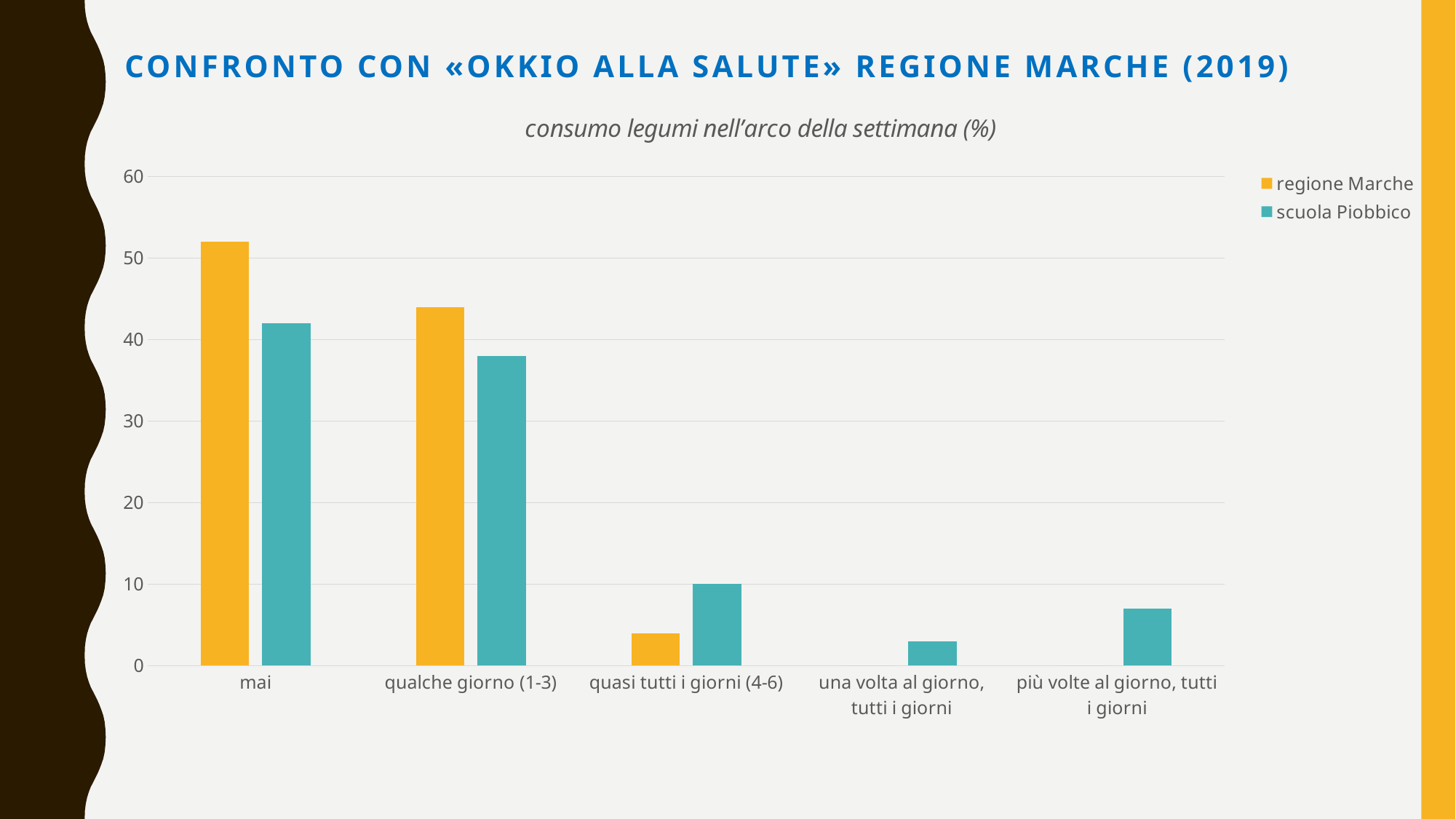
Which category has the highest value for scuola Piobbico? mai Which category has the highest value for regione Marche? mai For the category 'quasi tutti i giorni (4-6)', which series has the larger value, regione Marche or scuola Piobbico? scuola Piobbico What kind of chart is shown on the slide? bar chart For the category 'mai', which series has the larger value, regione Marche or scuola Piobbico? regione Marche Is the value for regione Marche in the category 'mai' greater or less than 50? greater Is the value for scuola Piobbico in the category 'qualche giorno (1-3)' greater or less than 40? less Which category has the lowest value for scuola Piobbico? una volta al giorno, tutti i giorni How many categories are shown on the x axis? 5 How many series does the legend list? 2 Is the value for regione Marche in the category 'quasi tutti i giorni (4-6)' greater or less than 10? less What is the title of the chart? consumo legumi nell'arco della settimana (%)